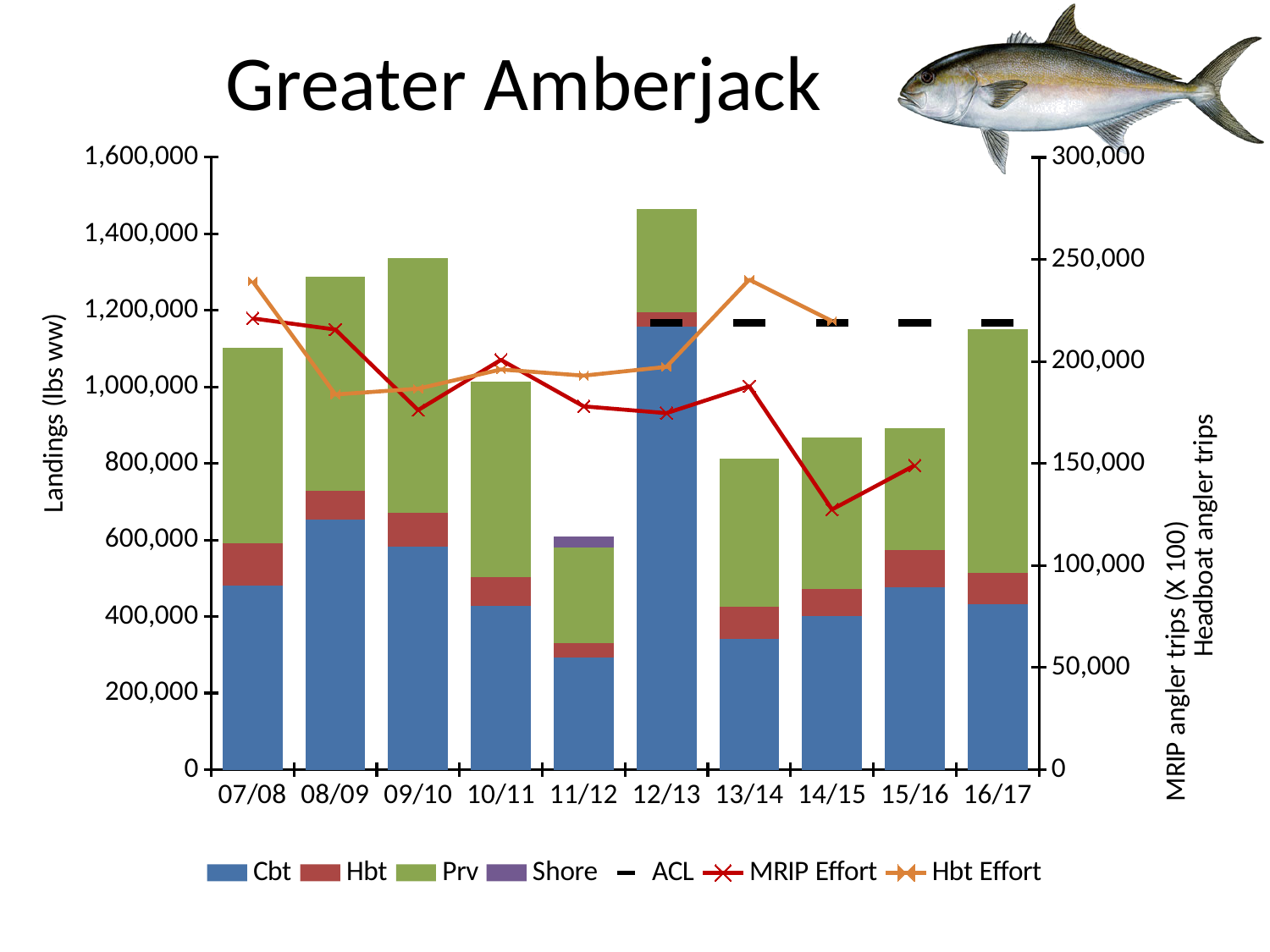
What kind of chart is shown on the slide? A combination chart of stacked bars with line series Is the Cbt landings value for 12/13 greater or less than 1,000,000? greater How many fishing years are shown on the x axis? 10 How many series does the legend list? 7 Is the total landings value for 12/13 greater or less than 1,400,000? greater In which year does the Shore series appear in the stacked bars? 11/12 Which year has the highest total landings bar? 12/13 Is the total landings value for 16/17 greater or less than 1,000,000? greater Which year has the lowest total landings bar? 11/12 Which year has a larger total landings bar, 12/13 or 16/17? 12/13 In which year is the MRIP Effort line at its lowest point? 14/15